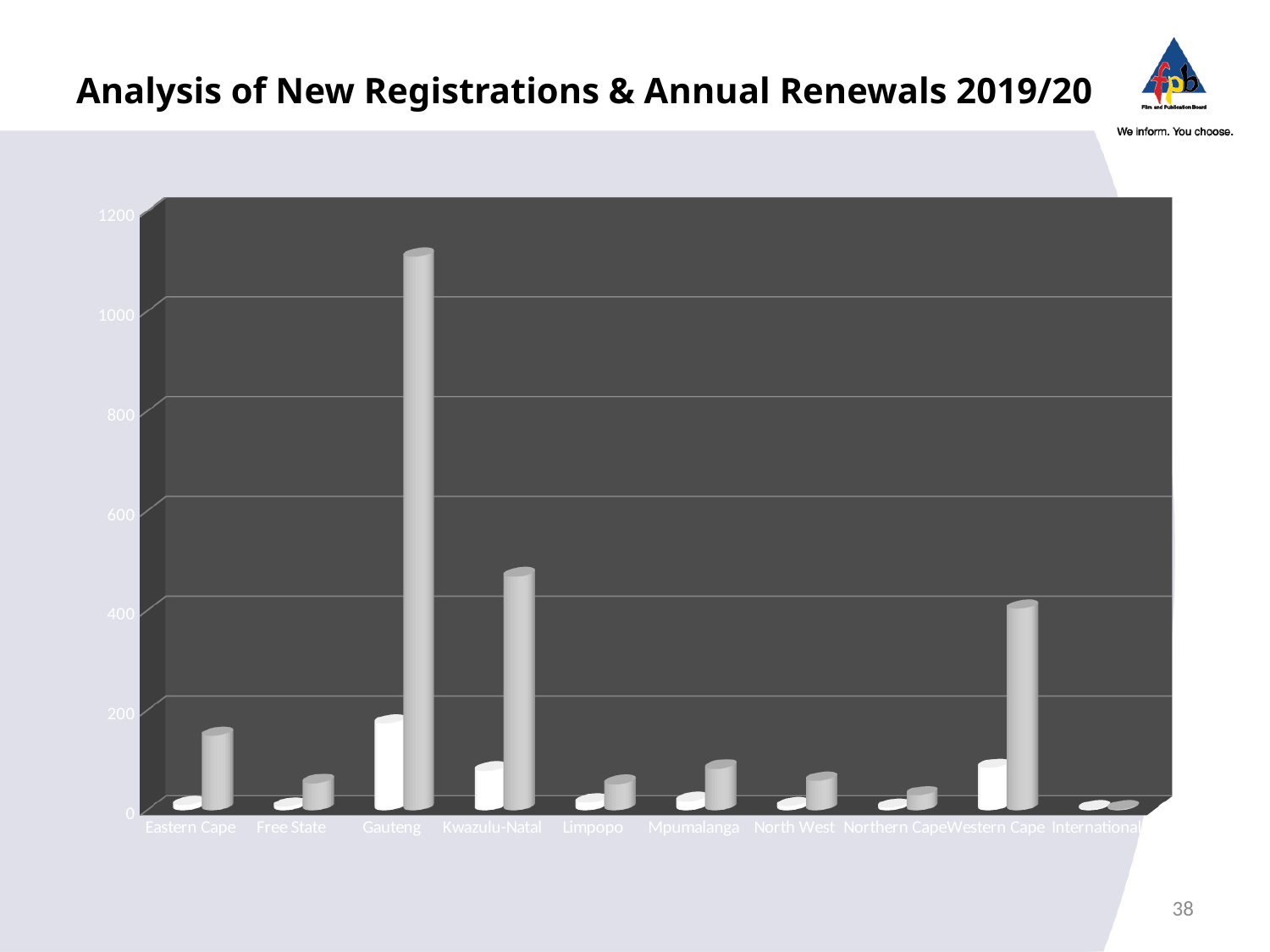
What is the title of the slide containing the chart? Analysis of New Registrations & Annual Renewals 2019/20 Is the grey bar for Gauteng greater or less than 1000? greater Which category has the tallest white bar in the chart? Gauteng Is the grey bar for Eastern Cape greater or less than 200? less Which has the taller grey bar, Eastern Cape or Free State? Eastern Cape What kind of chart is shown on the slide? bar chart Which category has the shortest grey bar in the chart? International Which category has the tallest grey bar in the chart? Gauteng Is the grey bar for Kwazulu-Natal greater or less than 400? greater How many categories are shown along the x axis of the chart? 10 Which has the taller grey bar, Gauteng or Kwazulu-Natal? Gauteng